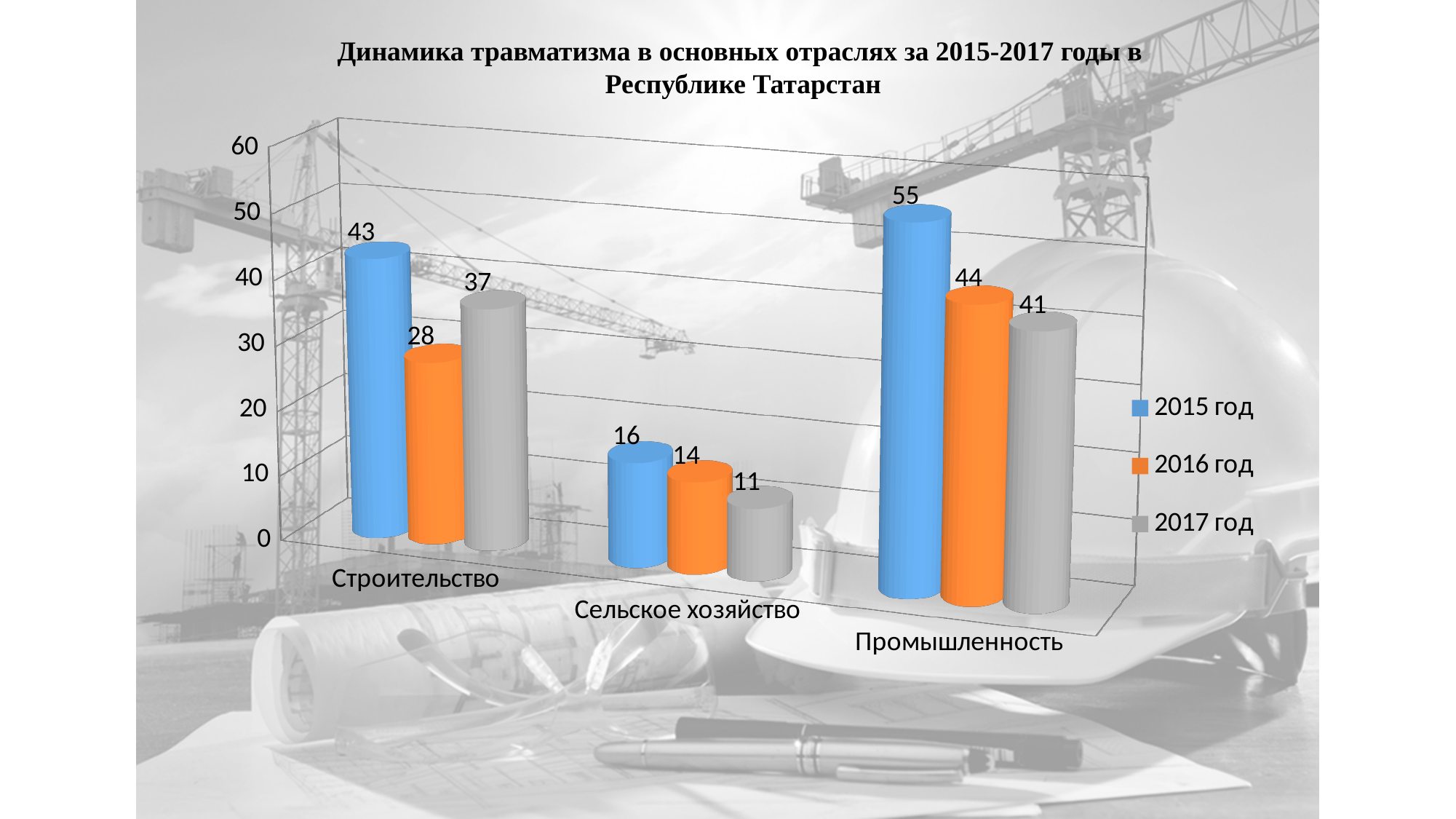
Do the values for Сельское хозяйство rise or fall from 2015 год to 2017 год? fall Which category has the highest value in the 2015 год series? Промышленность What is the value for Строительство in 2015 год? 43 Which category has the lowest value in the 2016 год series? Сельское хозяйство How many categories are shown on the x axis? 3 Which is larger for Промышленность: the 2016 год value or the 2017 год value? 2016 год What is the difference between the 2015 год and 2016 год values for Строительство? 15 Is the value for Промышленность in 2015 год greater or less than 50? greater What is the value for Промышленность in 2016 год? 44 What kind of chart is shown on the slide? bar chart What is the value for Сельское хозяйство in 2017 год? 11 How many series does the legend list? 3